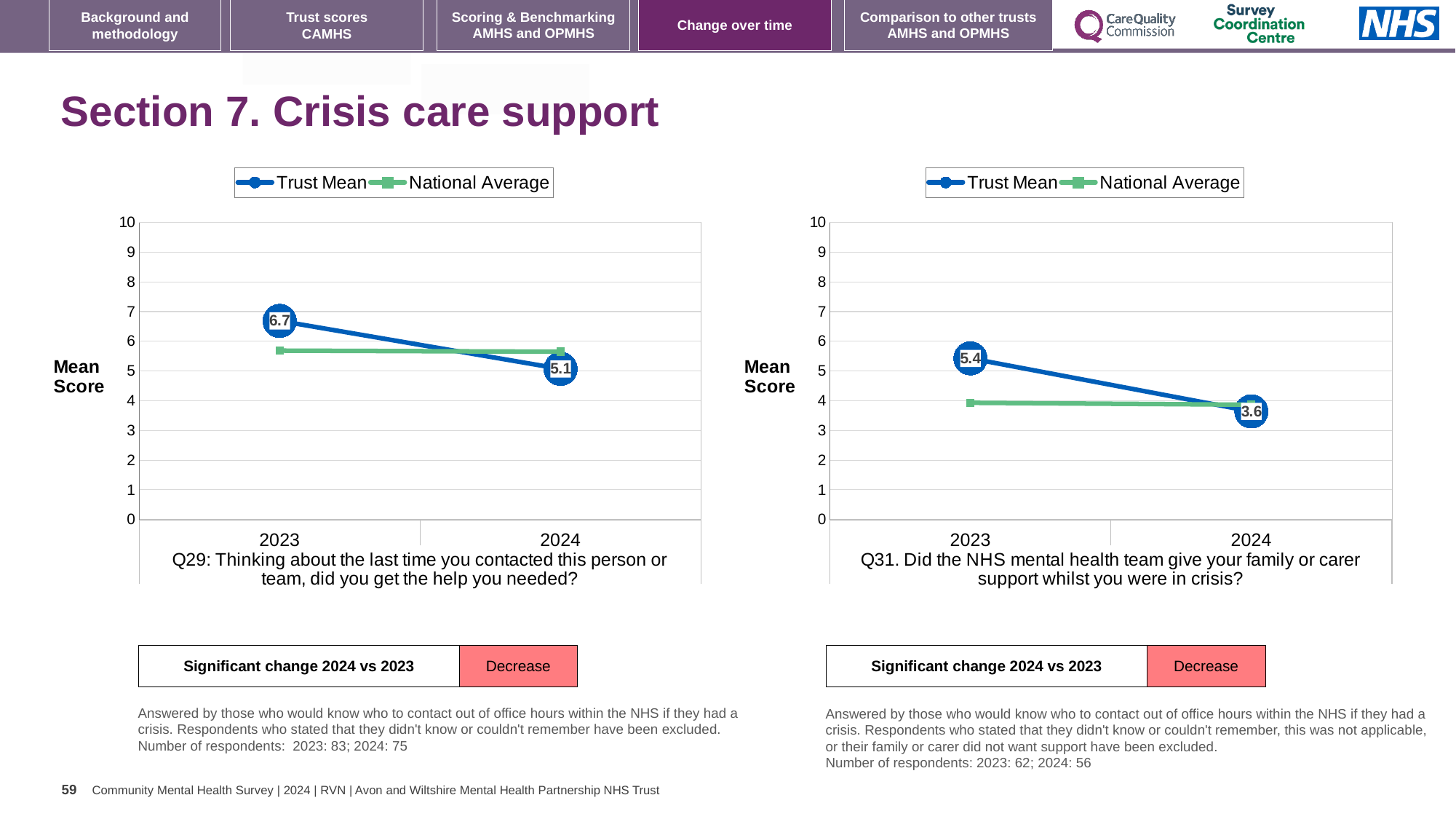
In the Q31 chart (right), what is the Trust Mean score for 2023? 5.4 In the Q29 chart (left), does the Trust Mean rise or fall from 2023 to 2024? fall In the Q31 chart (right), is the National Average for 2024 greater or less than 5? less In the Q29 chart (left), what is the Trust Mean score for 2023? 6.7 In the Q31 chart (right), which is higher in 2023, the Trust Mean or the National Average? Trust Mean In the Q29 chart (left), by how much did the Trust Mean fall from 2023 to 2024? 1.6 How many series does the legend of the Q29 chart (left) list? 2 In the Q31 chart (right), what is the Trust Mean score for 2024? 3.6 In the Q31 chart (right), what is the difference between the Trust Mean in 2023 and in 2024? 1.8 In the Q29 chart (left), what is the Trust Mean score for 2024? 5.1 What type of chart is the Q31 chart (right)? line chart In the Q29 chart (left), is the National Average for 2023 greater or less than 5? greater